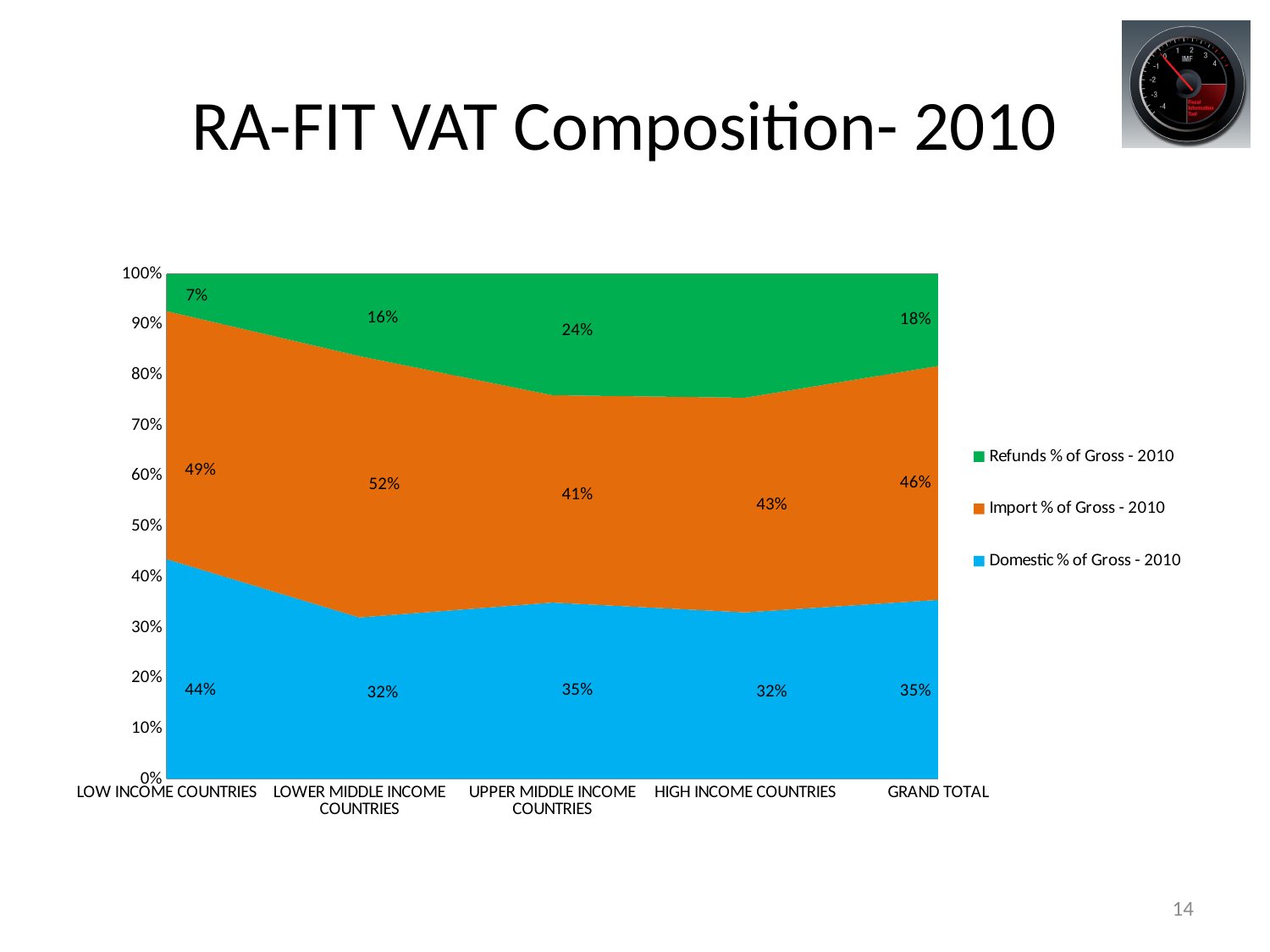
How many series does the legend list? 3 What is the Import % of Gross - 2010 value for Lower Middle Income Countries? 52% Which category has the lowest Refunds % of Gross - 2010 value? Low Income Countries How many categories are shown on the x axis of the chart? 5 What is the Refunds % of Gross - 2010 value for Upper Middle Income Countries? 24% What is the difference between the Import % of Gross - 2010 values for Lower Middle Income Countries and Upper Middle Income Countries? 11 percentage points Which category has the highest Domestic % of Gross - 2010 value? Low Income Countries Which category has the highest Import % of Gross - 2010 value? Lower Middle Income Countries What is the Domestic % of Gross - 2010 value for Low Income Countries? 44% What kind of chart is shown on the slide? Stacked area chart Which has the larger Domestic % of Gross - 2010 value: Low Income Countries or Lower Middle Income Countries? Low Income Countries What is the Import % of Gross - 2010 value for the Grand Total? 46%